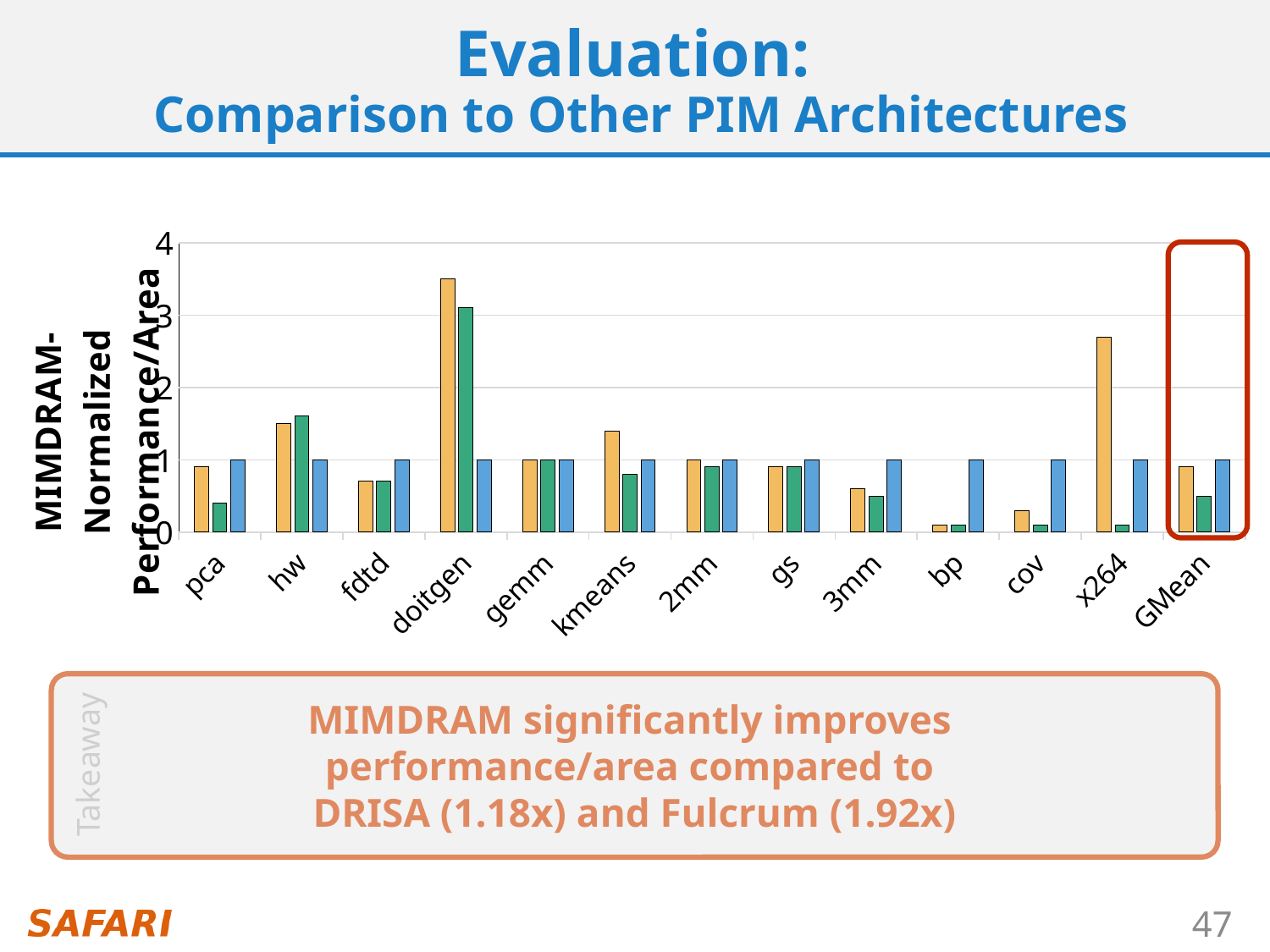
What is the label of the last category on the x axis? GMean For kmeans, which is larger: the orange bar or the green bar? orange What is the y-axis title of the chart? MIMDRAM-Normalized Performance/Area Is the orange bar for x264 greater or less than 2? greater Which category has the lowest orange bar? bp How many categories are shown along the x axis of the chart? 13 What kind of chart is shown on the slide? bar chart Is the green bar for GMean greater or less than 1? less For doitgen, which is larger: the orange bar or the blue bar? orange Which category has the highest orange bar? doitgen Is the orange bar for doitgen greater or less than 3? greater